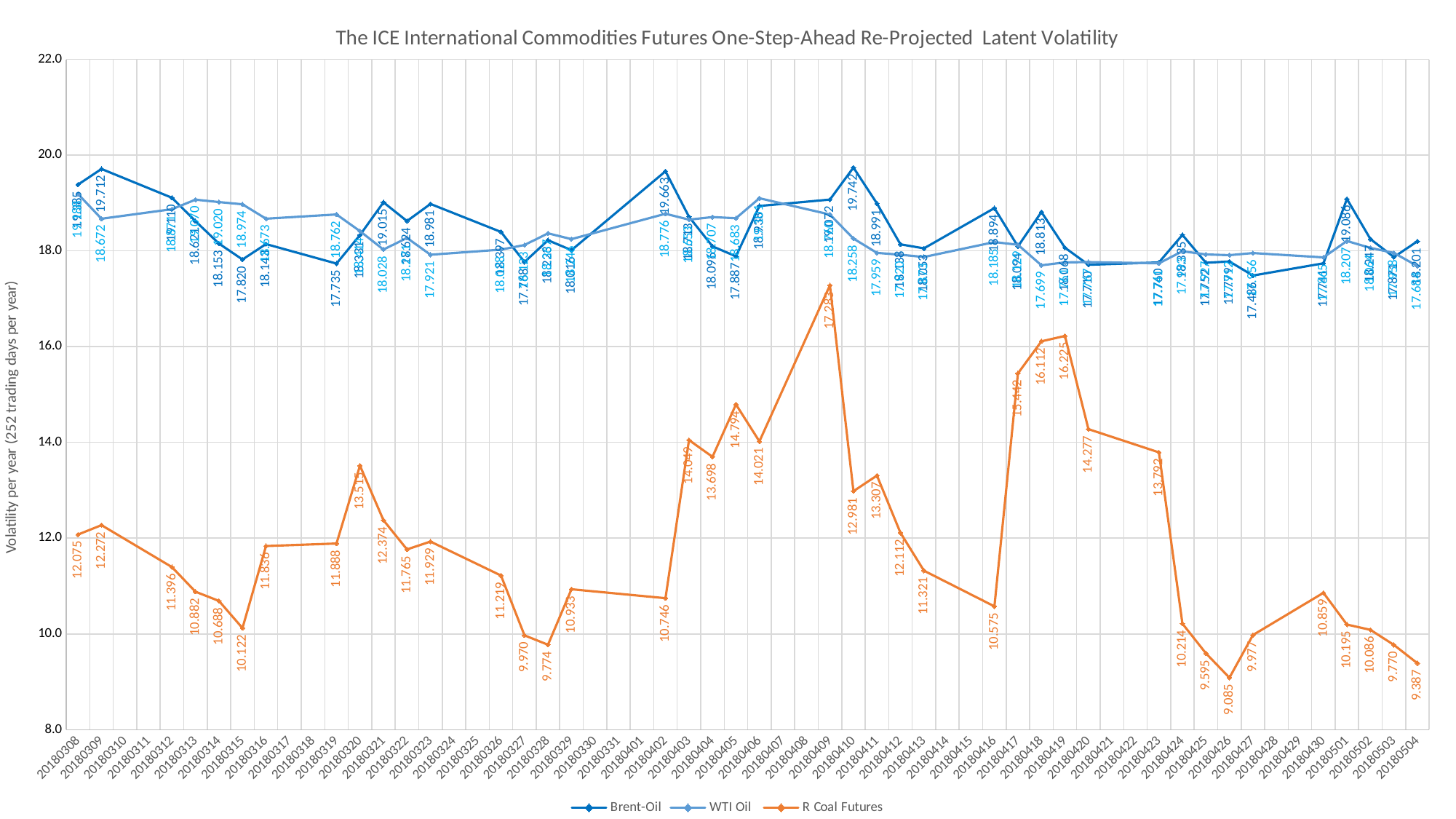
On which date is the R Coal Futures value lowest? 20180426 What is the difference between the R Coal Futures values on 20180419 and 20180418? 0.113 What is the R Coal Futures value on 20180308? 12.075 Is the R Coal Futures value on 20180409 greater or less than 16.0? greater Which series has the larger value on 20180309, Brent-Oil or WTI Oil? Brent-Oil What is the Brent-Oil value on 20180309? 19.712 What is the label of the vertical axis? Volatility per year (252 trading days per year) What is the R Coal Futures value on 20180426? 9.085 On which date is the R Coal Futures value highest? 20180409 How many series does the legend list? 3 What type of chart is shown on the slide? line chart What is the WTI Oil value on 20180309? 18.672